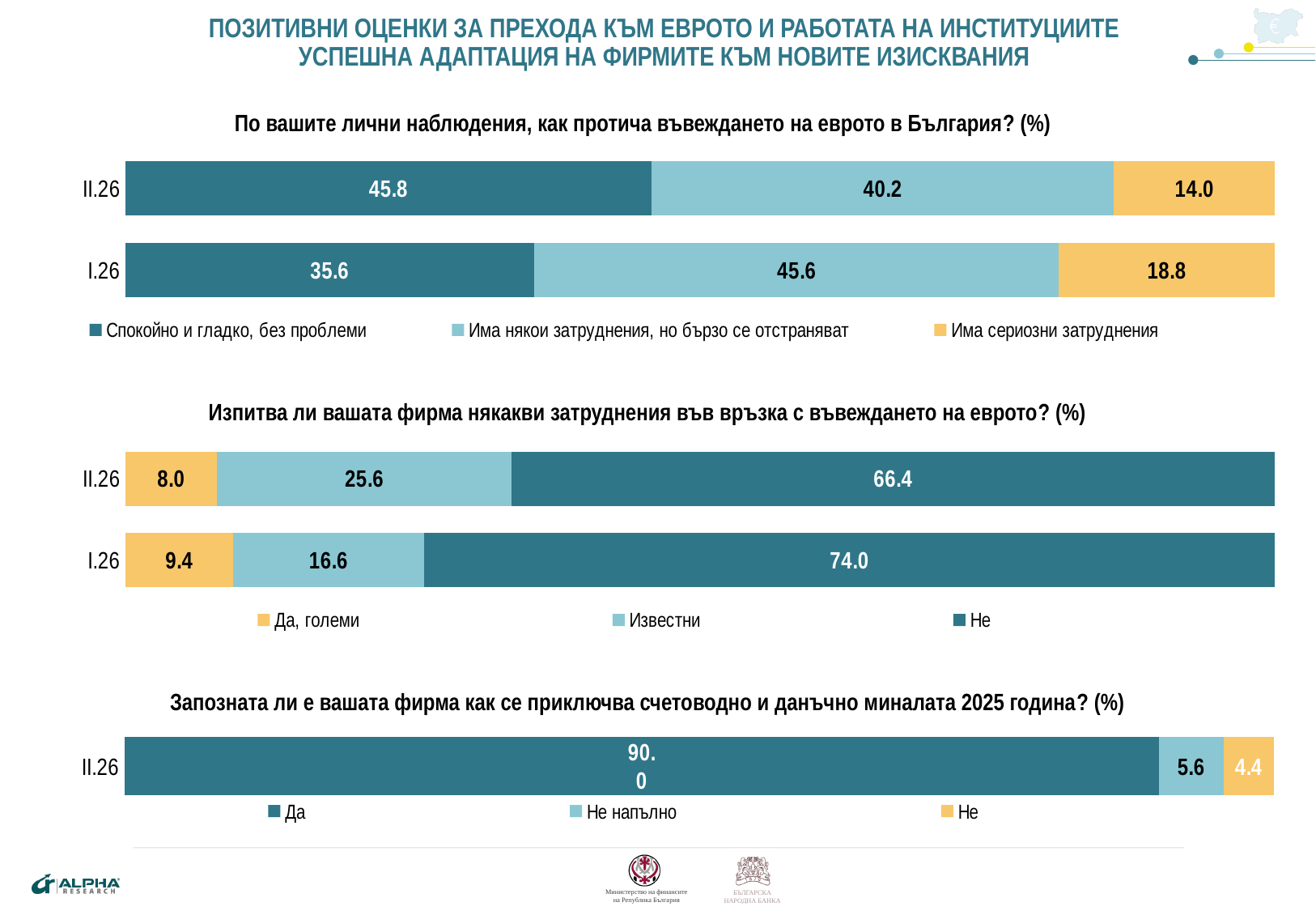
In the chart 'Изпитва ли вашата фирма някакви затруднения във връзка с въвеждането на еврото? (%)', what is the value for 'Известни' in II.26? 25.6 In the chart 'По вашите лични наблюдения, как протича въвеждането на еврото в България? (%)', what is the difference between the 'Спокойно и гладко, без проблеми' values for II.26 and I.26? 10.2 In the chart 'Запозната ли е вашата фирма как се приключва счетоводно и данъчно миналата 2025 година? (%)', what is the value for 'Не напълно'? 5.6 In the chart 'По вашите лични наблюдения, как протича въвеждането на еврото в България? (%)', which series has the largest value in I.26? Има някои затруднения, но бързо се отстраняват What kind of chart is the chart 'Запозната ли е вашата фирма как се приключва счетоводно и данъчно миналата 2025 година? (%)'? Stacked bar chart In the chart 'По вашите лични наблюдения, как протича въвеждането на еврото в България? (%)', what is the value for 'Спокойно и гладко, без проблеми' in II.26? 45.8 In the chart 'Изпитва ли вашата фирма някакви затруднения във връзка с въвеждането на еврото? (%)', what is the total of the I.26 bar? 100.0 In the chart 'По вашите лични наблюдения, как протича въвеждането на еврото в България? (%)', how many series does the legend list? 3 In the chart 'Изпитва ли вашата фирма някакви затруднения във връзка с въвеждането на еврото? (%)', which is larger: the 'Не' value for I.26 or for II.26? I.26 In the chart 'Изпитва ли вашата фирма някакви затруднения във връзка с въвеждането на еврото? (%)', what is the difference between the 'Не' values for I.26 and II.26? 7.6 In the chart 'Запозната ли е вашата фирма как се приключва счетоводно и данъчно миналата 2025 година? (%)', which series has the smallest value? Не In the chart 'По вашите лични наблюдения, как протича въвеждането на еврото в България? (%)', what is the value for 'Има сериозни затруднения' in I.26? 18.8